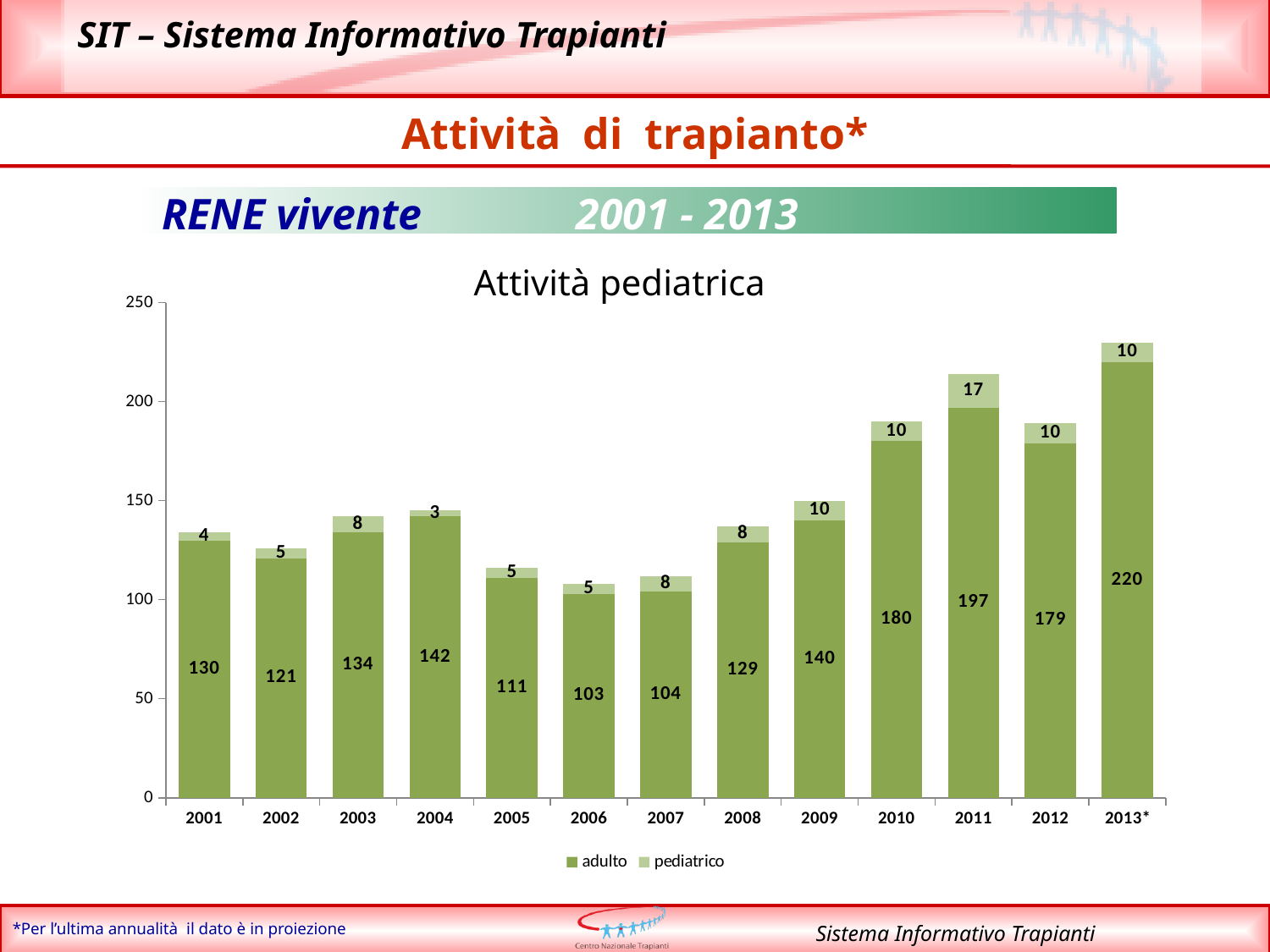
What is the pediatrico value for 2011? 17 What kind of chart is shown? stacked bar chart Which year has the lowest adulto value? 2006 How many years are shown on the x axis? 13 What is the total of the stacked bar for 2010? 190 How many series does the legend list? 2 What is the title of the chart? Attività pediatrica What is the difference between the adulto values for 2011 and 2012? 18 Which year has the highest adulto value? 2013* What is the adulto value for 2013*? 220 Which is larger, the adulto value for 2003 or for 2008? 2003 What is the adulto value for 2004? 142